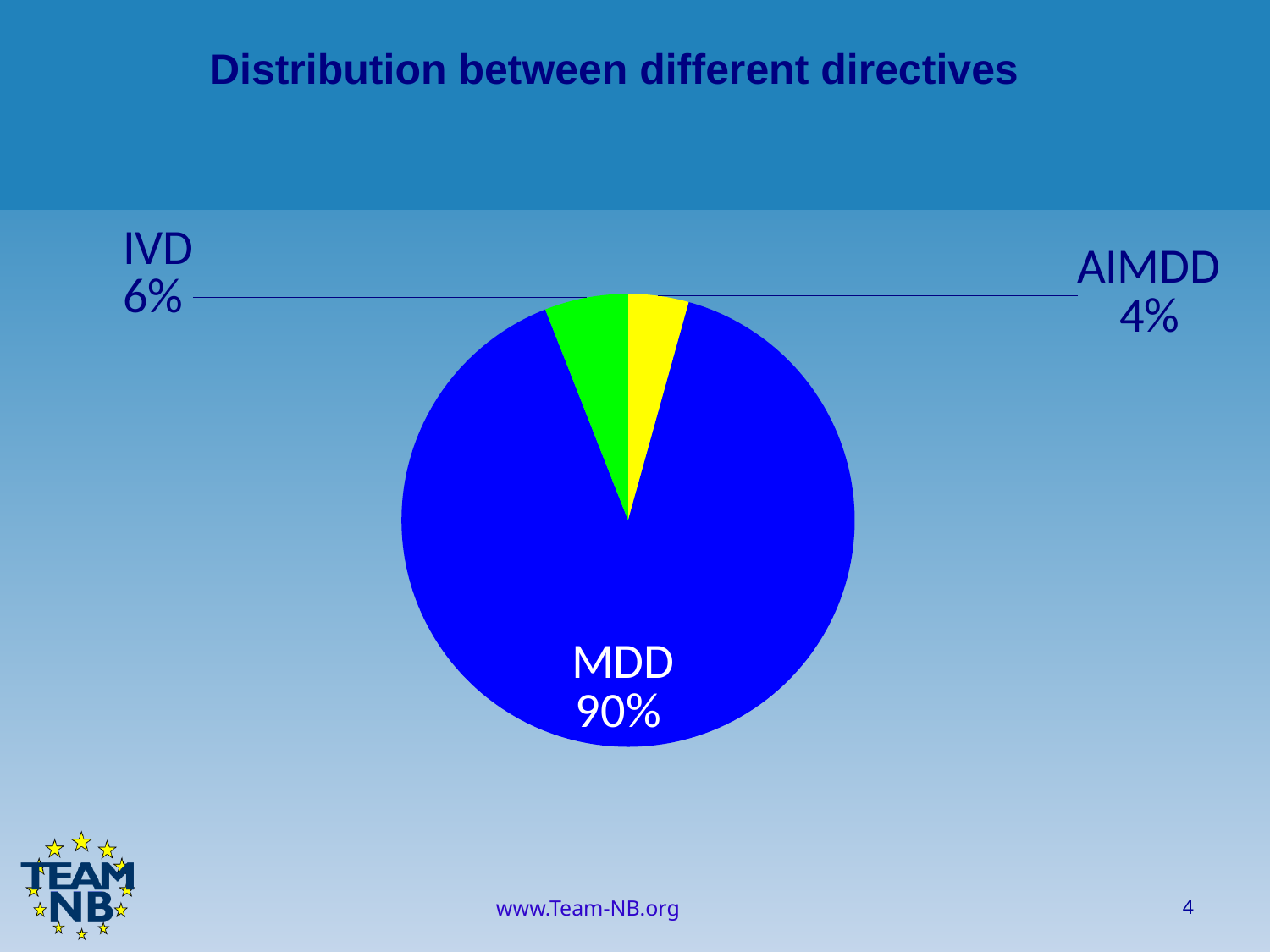
What colour is the MDD slice? blue What is the title of the chart? Distribution between different directives What share of the pie does MDD account for? 90% What kind of chart is shown on the slide? pie chart What share of the pie does IVD account for? 6% What is the difference in percentage points between the MDD share and the IVD share? 84 What is the difference in percentage points between the IVD share and the AIMDD share? 2 What share of the pie does AIMDD account for? 4% How many slices does the pie chart have? 3 Which directive has the smallest share of the pie? AIMDD Which directive has the largest share of the pie? MDD Which has a larger share, IVD or AIMDD? IVD